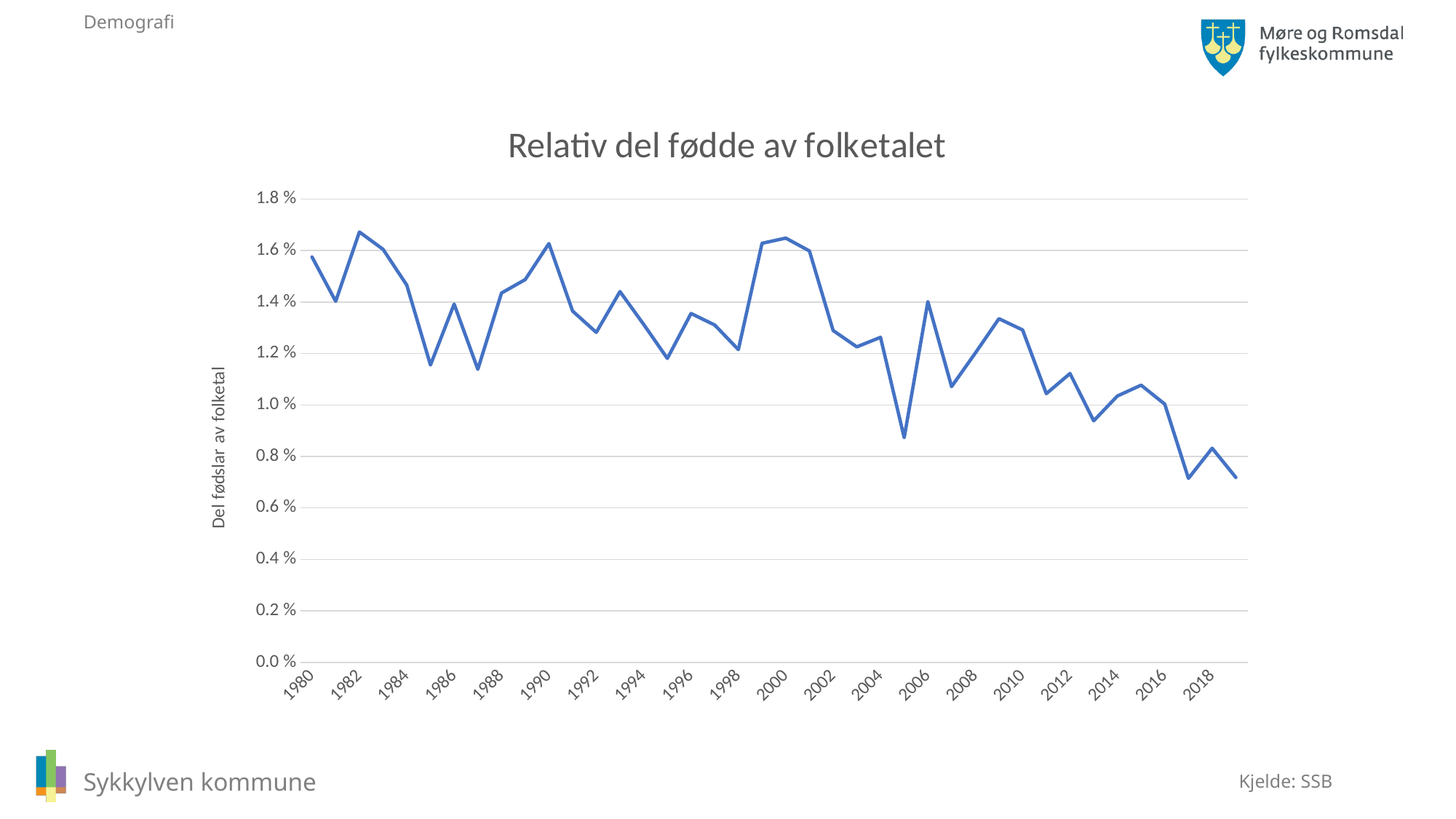
Is the value for 2017 greater or less than 0.8 %? less What is the title of the chart? Relativ del fødde av folketalet Is the value for 2005 greater or less than 1.0 %? less Is the value for 1985 greater or less than 1.4 %? less Which year has the larger value, 1980 or 2018? 1980 What kind of chart is shown on the slide? line chart Which year has the larger value, 1990 or 2005? 1990 What is the label on the vertical axis of the chart? Del fødslar av folketal Overall, do the values rise or fall from 1980 to the end of the series? fall